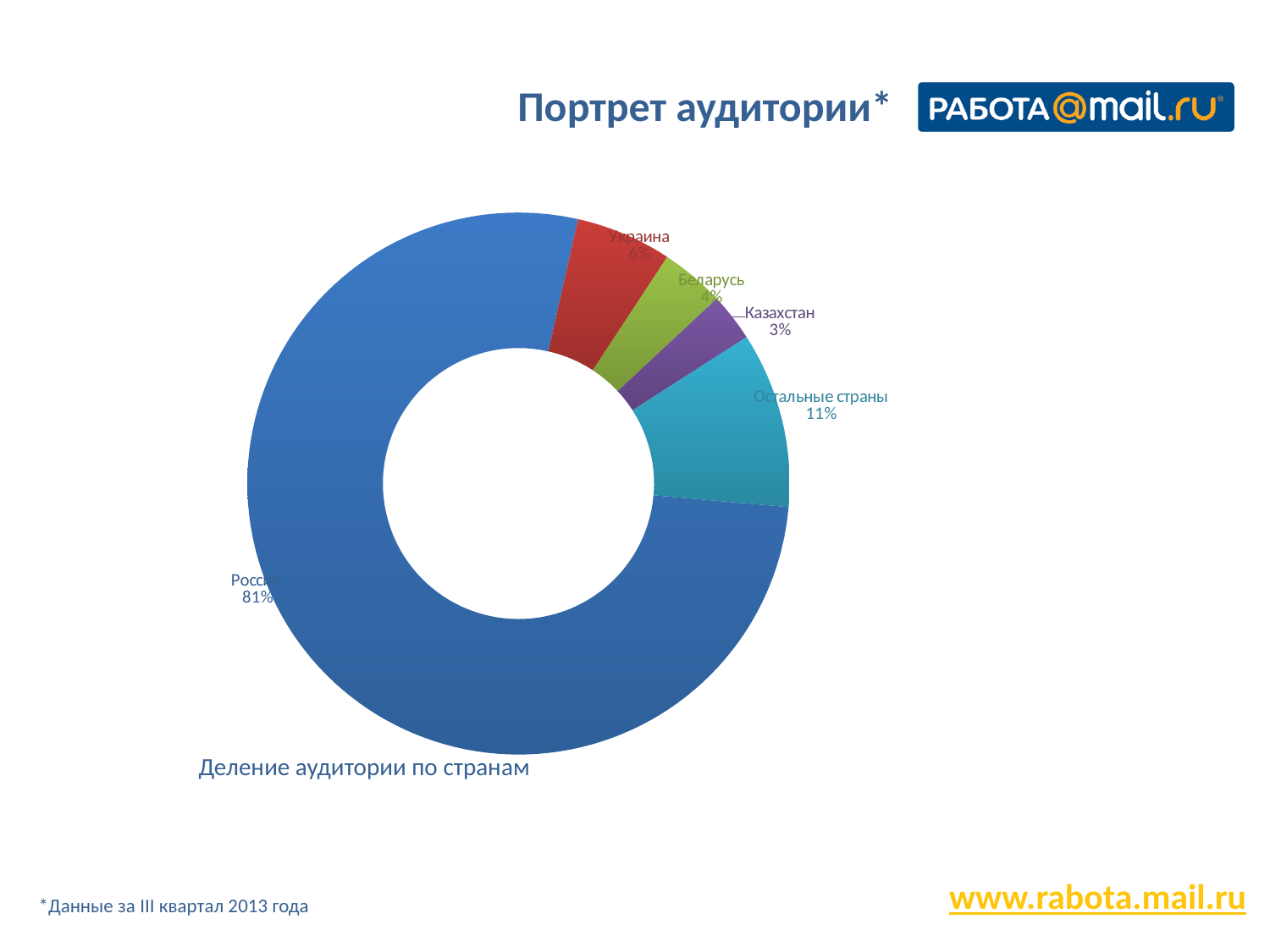
Which country has the largest share of the audience? Россия What is the title of the chart? Деление аудитории по странам What share of the audience is from Остальные страны? 11% Which has a larger share of the audience, Украина or Беларусь? Украина What share of the audience is from Беларусь? 4% What kind of chart is shown on the slide? Doughnut (pie) chart What is the difference in percentage points between the shares of Россия and Остальные страны? 70 How many categories are shown in the chart? 5 Which category has the smallest share of the audience? Казахстан What share of the audience is from Казахстан? 3% What share of the audience is from Украина? 6% What share of the audience is from Россия? 81%